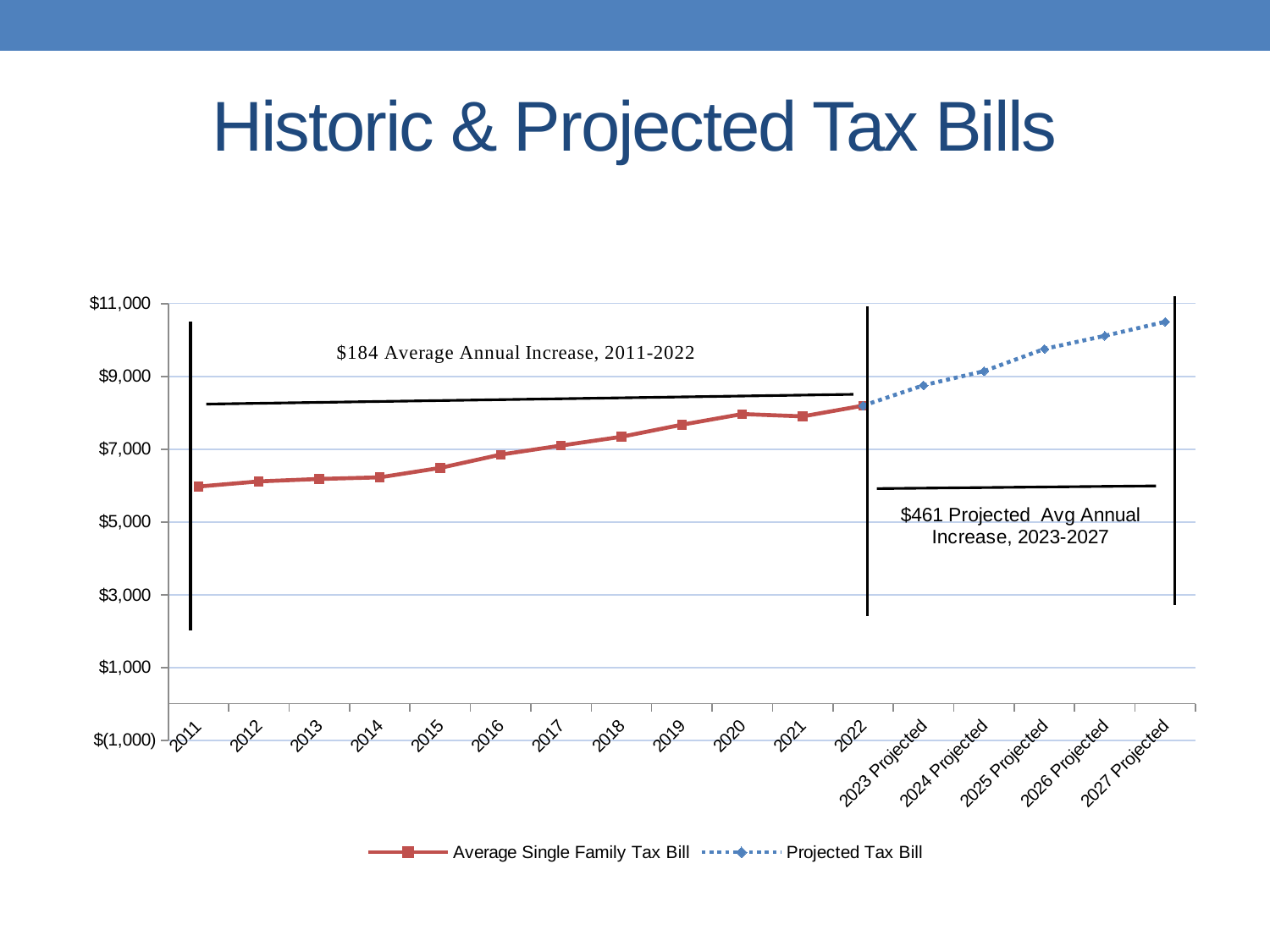
How many years (categories) are shown along the x axis? 17 Which year has the highest value on the chart? 2027 Projected How many series does the legend list? 2 What kind of chart is shown on the slide? Line chart According to the annotation on the chart, what is the projected average annual increase for 2023-2027? $461 Is the Average Single Family Tax Bill for 2011 greater or less than $7,000? less Does the Average Single Family Tax Bill generally rise or fall from 2011 to 2022? Rise Is the Projected Tax Bill for 2027 Projected greater or less than $9,000? greater Which year has the lowest Average Single Family Tax Bill? 2011 Which is larger, the Average Single Family Tax Bill in 2022 or in 2011? 2022 Is the Average Single Family Tax Bill for 2020 greater or less than $7,000? greater According to the annotation on the chart, what was the average annual increase from 2011 to 2022? $184